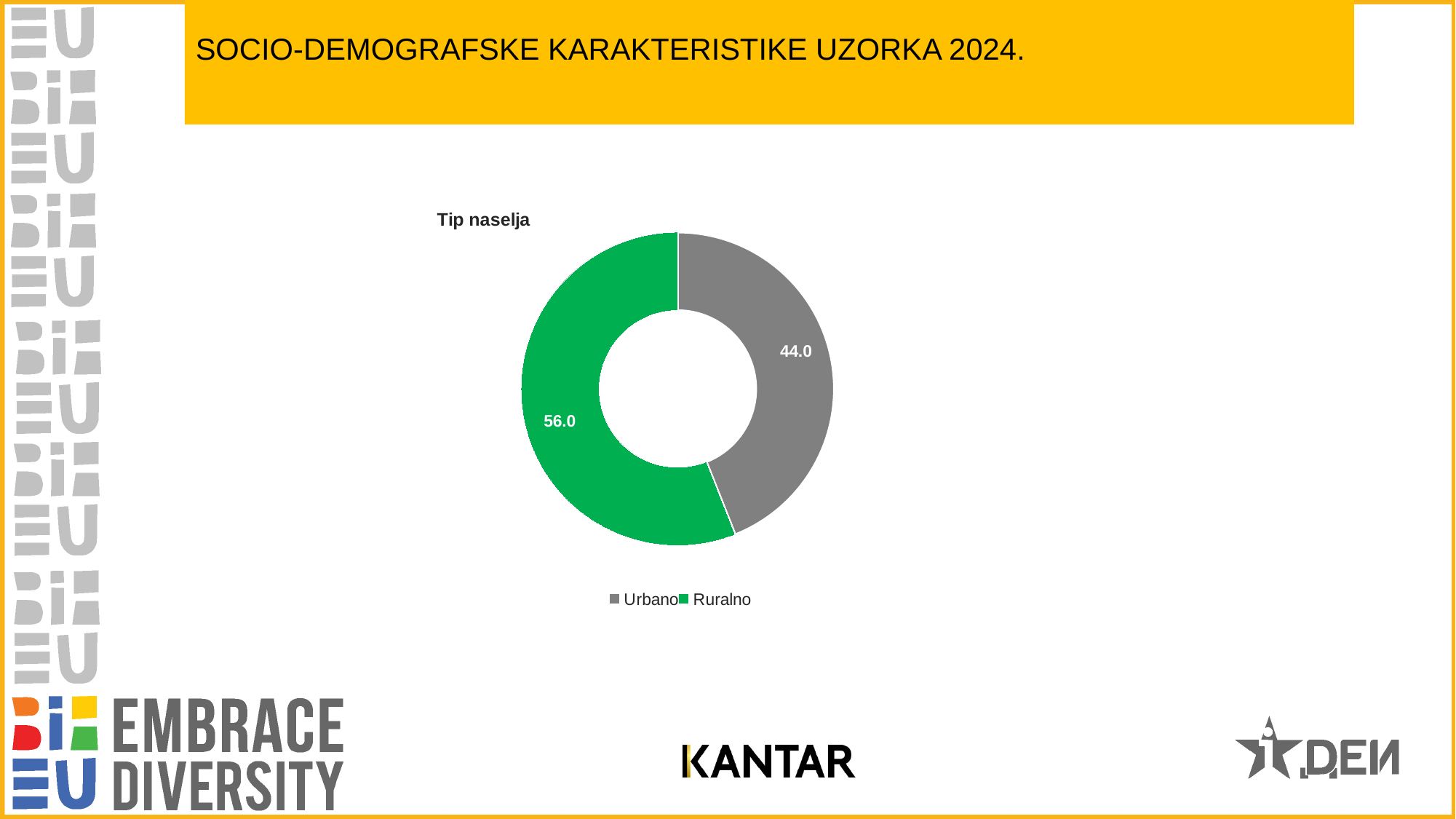
How many categories are shown in the Tip naselja chart? 2 What is the difference between the Ruralno and Urbano values in the Tip naselja chart? 12.0 What is the title of the chart on the slide? Tip naselja What is the value for Ruralno in the Tip naselja chart? 56.0 What kind of chart is the Tip naselja chart? Doughnut (pie) chart How many entries does the legend of the Tip naselja chart list? 2 What colour represents Ruralno in the Tip naselja chart? Green What is the total of the two values shown in the Tip naselja chart? 100.0 Which category has the largest share in the Tip naselja chart? Ruralno Which category has the smallest share in the Tip naselja chart? Urbano Which is larger in the Tip naselja chart, Urbano or Ruralno? Ruralno What is the value for Urbano in the Tip naselja chart? 44.0